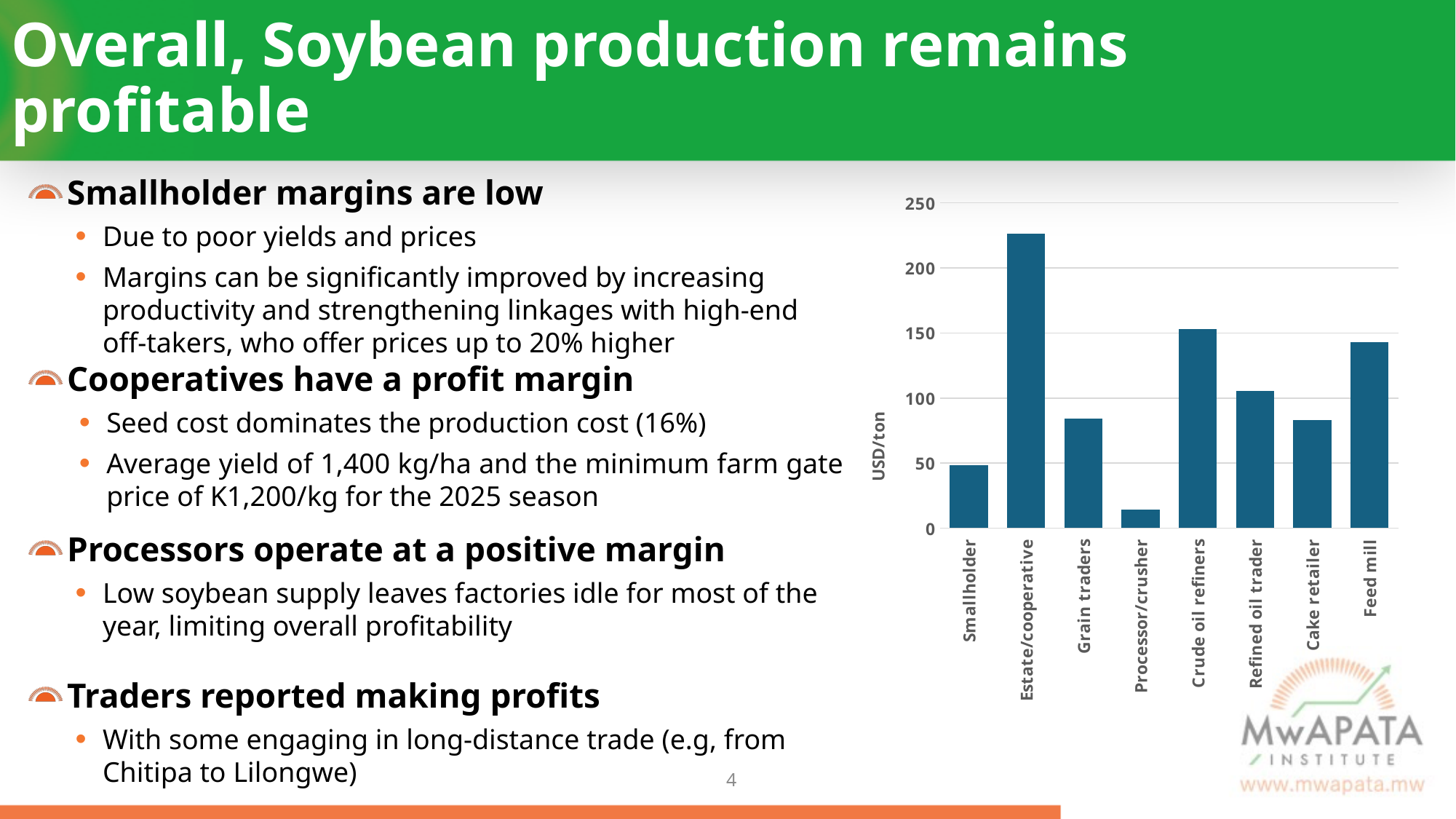
Is the value for Processor/crusher greater or less than 50? less What kind of chart is shown on the slide? bar chart Which category has the highest value in the chart? Estate/cooperative Which category has the lowest value in the chart? Processor/crusher Which is larger, the value for Smallholder or the value for Grain traders? Grain traders Is the value for Estate/cooperative greater or less than 200? greater What is the label on the vertical axis of the chart? USD/ton Which is larger, the value for Feed mill or the value for Refined oil trader? Feed mill How many categories are shown on the x axis of the chart? 8